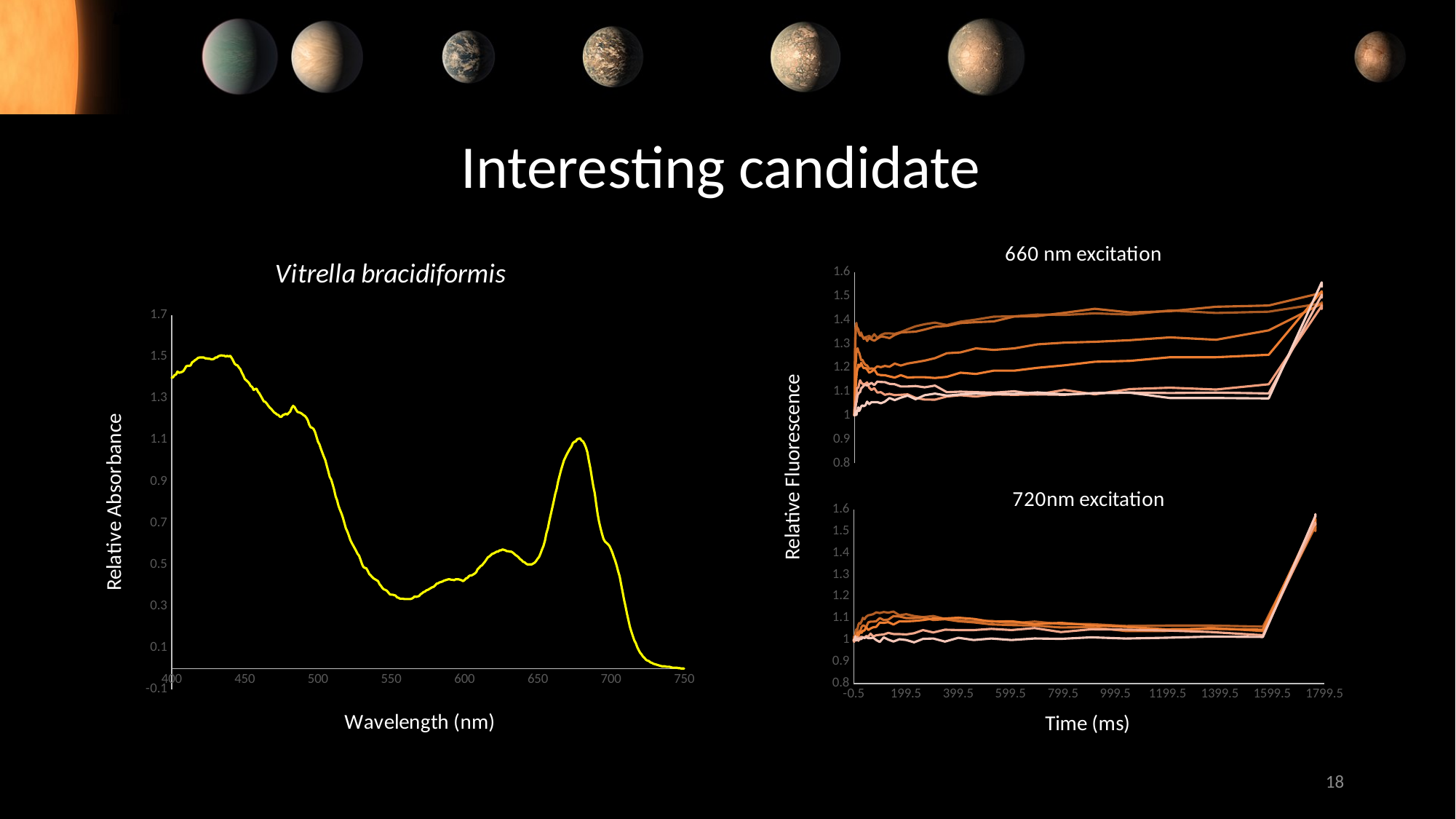
What kind of chart is the Vitrella bracidiformis chart on the left? line chart In the 720nm excitation chart, are the values at 999.5 ms greater or less than 1.2? less In the Vitrella bracidiformis chart, is the relative absorbance at 750 nm greater or less than 0.3? less In the Vitrella bracidiformis chart, which wavelength has the higher relative absorbance, 625 nm or 680 nm? 680 nm In the 720nm excitation chart, do the values rise or fall between 1599.5 ms and 1799.5 ms? rise In the Vitrella bracidiformis chart, is the relative absorbance at 680 nm greater or less than 0.9? greater What is the highest y-axis tick value shown on the 660 nm excitation chart? 1.6 In the Vitrella bracidiformis chart, do the values rise or fall between 700 nm and 750 nm? fall What is the shared y-axis label of the two charts on the right? Relative Fluorescence What is the x-axis label of the Vitrella bracidiformis chart on the left? Wavelength (nm)